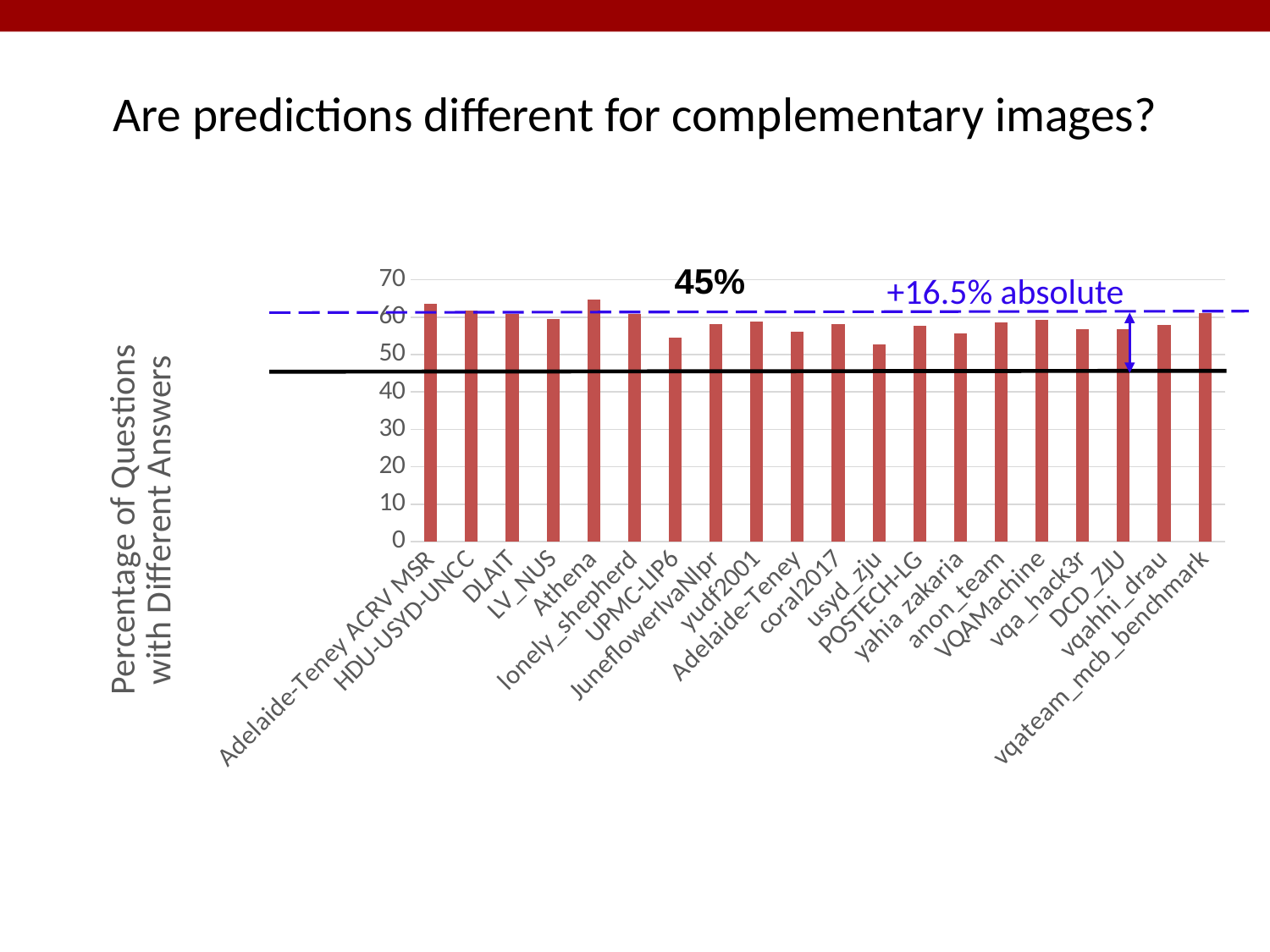
What value is annotated on the solid black horizontal line in the chart? 45% Which team has the lowest percentage of questions with different answers? usyd_zju What is the label on the y axis of the chart? Percentage of Questions with Different Answers Is the value for Athena greater or less than 60? greater Which team has the highest percentage of questions with different answers? Athena Is the value for UPMC-LIP6 greater or less than 50? greater What kind of chart is shown on the slide? bar chart How many teams (categories) are plotted on the x axis? 20 Which is larger, the value for Athena or the value for usyd_zju? Athena Is the value for DLAIT greater or less than 40? greater Which is larger, the value for Adelaide-Teney ACRV MSR or the value for UPMC-LIP6? Adelaide-Teney ACRV MSR